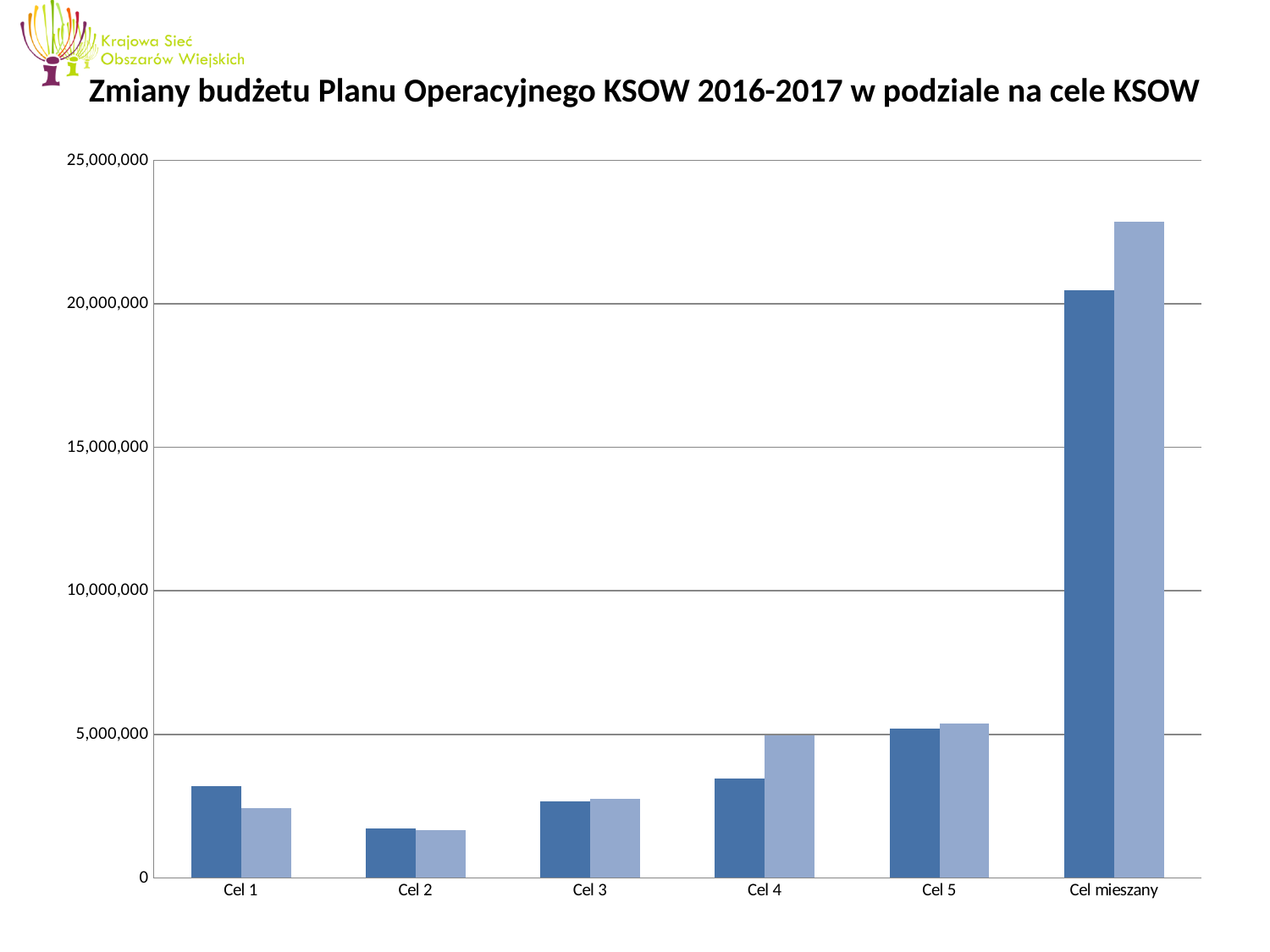
Which category has the highest bars in the chart? Cel mieszany Is the value of the light blue bar for Cel mieszany greater or less than 20,000,000? greater How many bars are plotted for each category in the chart? 2 For Cel 4, which bar is taller, the dark blue one or the light blue one? light blue What is the title of the chart on the slide? Zmiany budżetu Planu Operacyjnego KSOW 2016-2017 w podziale na cele KSOW What kind of chart is shown on the slide? bar chart Which is larger, the dark blue bar for Cel 5 or the dark blue bar for Cel 1? Cel 5 Is the value of the dark blue bar for Cel 1 greater or less than 5,000,000? less How many categories are shown on the x axis of the chart? 6 For Cel 1, which bar is taller, the dark blue one or the light blue one? dark blue Which category has the lowest bars in the chart? Cel 2 Is the value of the light blue bar for Cel 3 greater or less than 5,000,000? less